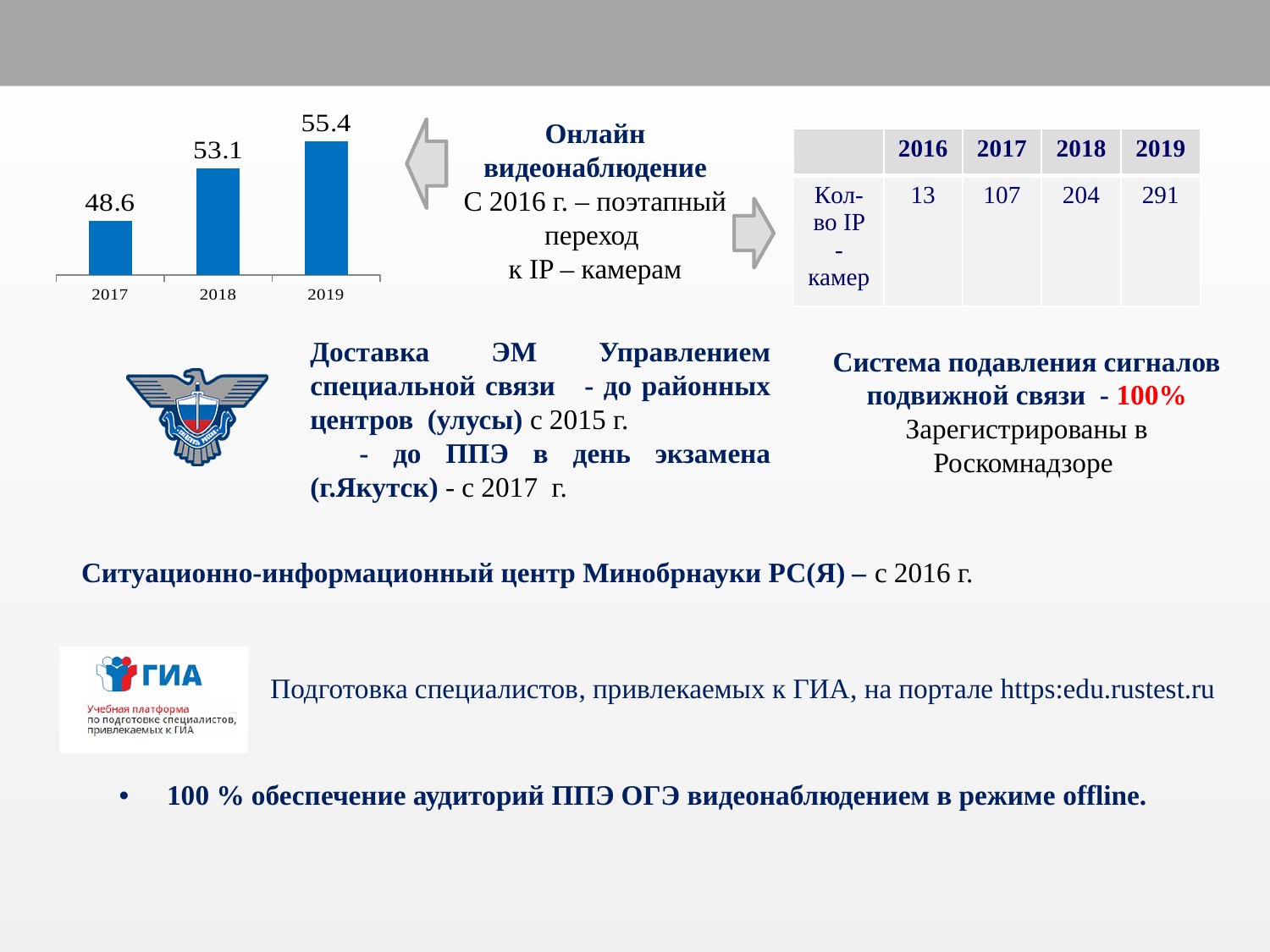
What is the difference between the 2019 and 2017 values in the bar chart? 6.8 Which is larger in the bar chart, the value for 2018 or the value for 2019? 2019 What colour are the bars in the bar chart? blue Which year has the lowest value in the bar chart? 2017 How many bars are shown in the bar chart? 3 What is the value for 2018 in the bar chart? 53.1 What is the value for 2017 in the bar chart? 48.6 What is the difference between the 2018 and 2017 values in the bar chart? 4.5 Do the values in the bar chart rise or fall from 2017 to 2019? rise What kind of chart is shown on the slide? bar chart Which year has the highest value in the bar chart? 2019 What is the value for 2019 in the bar chart? 55.4